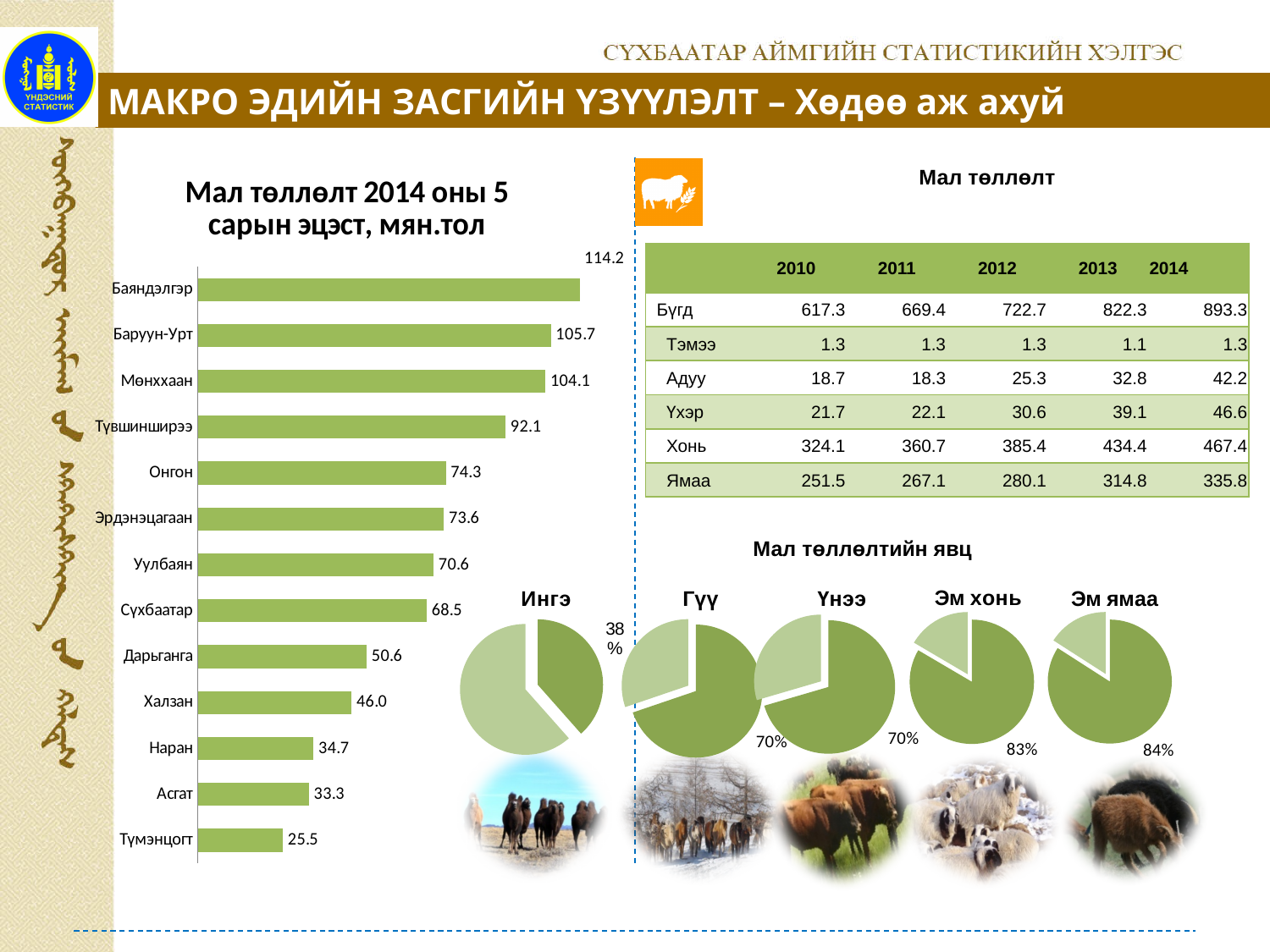
What kind of chart is 'Мал төллөлт 2014 оны 5 сарын эцэст, мян.тол'? bar chart In the pie chart 'Эм ямаа' under 'Мал төллөлтийн явц', what share is labelled? 84% In the bar chart 'Мал төллөлт 2014 оны 5 сарын эцэст, мян.тол', which category has the highest value? Баяндэлгэр In the bar chart 'Мал төллөлт 2014 оны 5 сарын эцэст, мян.тол', which category has the lowest value? Түмэнцогт How many categories are shown in the bar chart 'Мал төллөлт 2014 оны 5 сарын эцэст, мян.тол'? 13 In the bar chart 'Мал төллөлт 2014 оны 5 сарын эцэст, мян.тол', which is larger, Дарьганга or Сүхбаатар? Сүхбаатар How many pie charts are shown under 'Мал төллөлтийн явц'? 5 In the bar chart 'Мал төллөлт 2014 оны 5 сарын эцэст, мян.тол', what is the difference between Баруун-Урт and Мөнххаан? 1.6 In the bar chart 'Мал төллөлт 2014 оны 5 сарын эцэст, мян.тол', what is the value for Халзан? 46.0 In the bar chart 'Мал төллөлт 2014 оны 5 сарын эцэст, мян.тол', what is the value for Онгон? 74.3 In the pie chart 'Ингэ' under 'Мал төллөлтийн явц', what share is labelled on the dark green slice? 38% In the bar chart 'Мал төллөлт 2014 оны 5 сарын эцэст, мян.тол', what is the value for Баяндэлгэр? 114.2